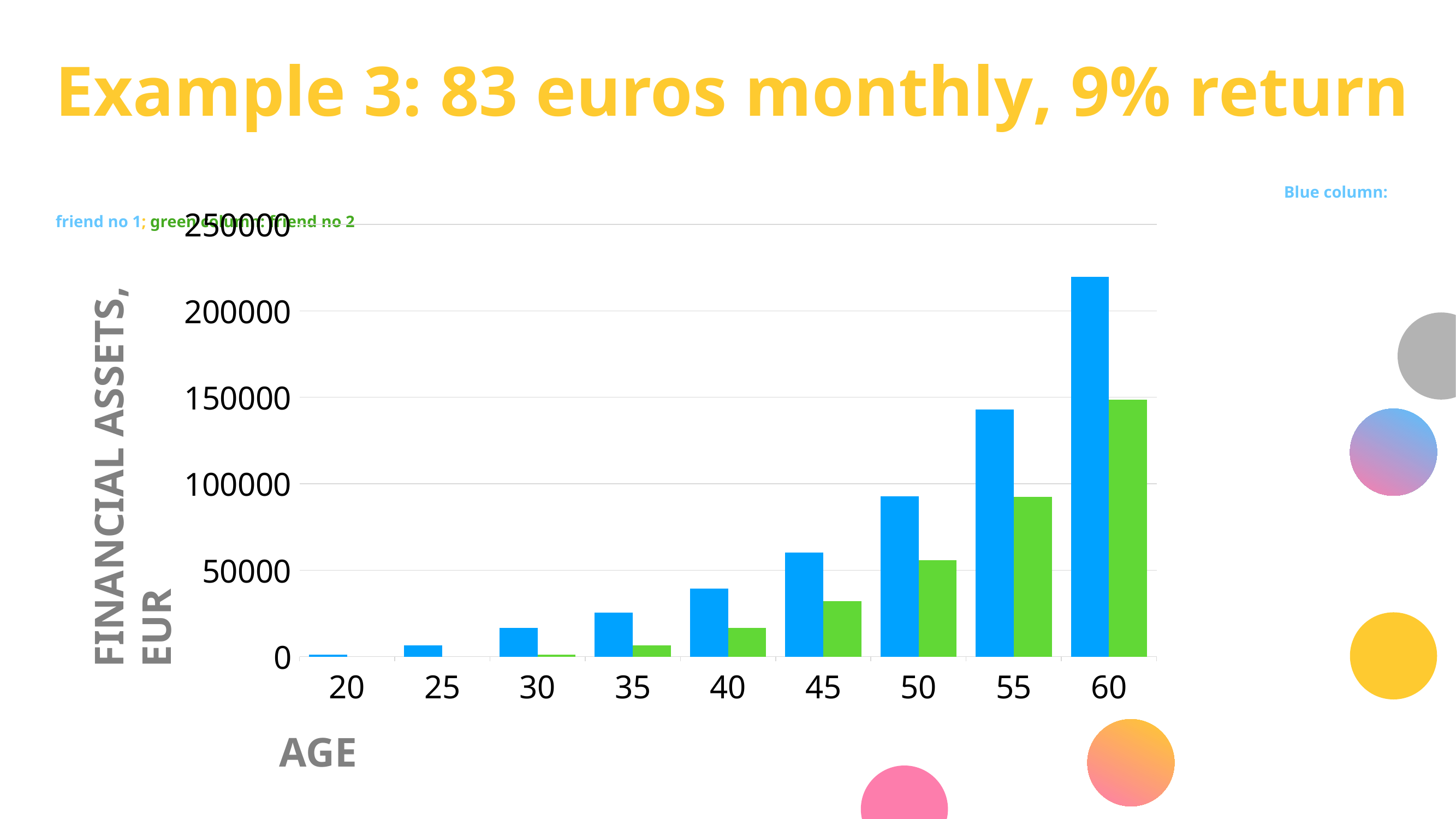
At which age is the blue bar (friend no 1) lowest? 20 At which age is the blue bar (friend no 1) highest? 60 Is the blue bar (friend no 1) at age 60 greater or less than 200000? greater Is the green bar (friend no 2) at age 45 greater or less than 50000? less What kind of chart is shown on the slide? bar chart How many series (bar colours) does the chart plot? 2 Do the blue bars (friend no 1) rise or fall as age increases along the x axis? rise Is the blue bar (friend no 1) at age 50 greater or less than 100000? less At age 60, which is larger: the blue bar (friend no 1) or the green bar (friend no 2)? blue bar (friend no 1) How many age categories are shown on the x axis of the chart? 9 What is the title of the x axis of the chart? AGE